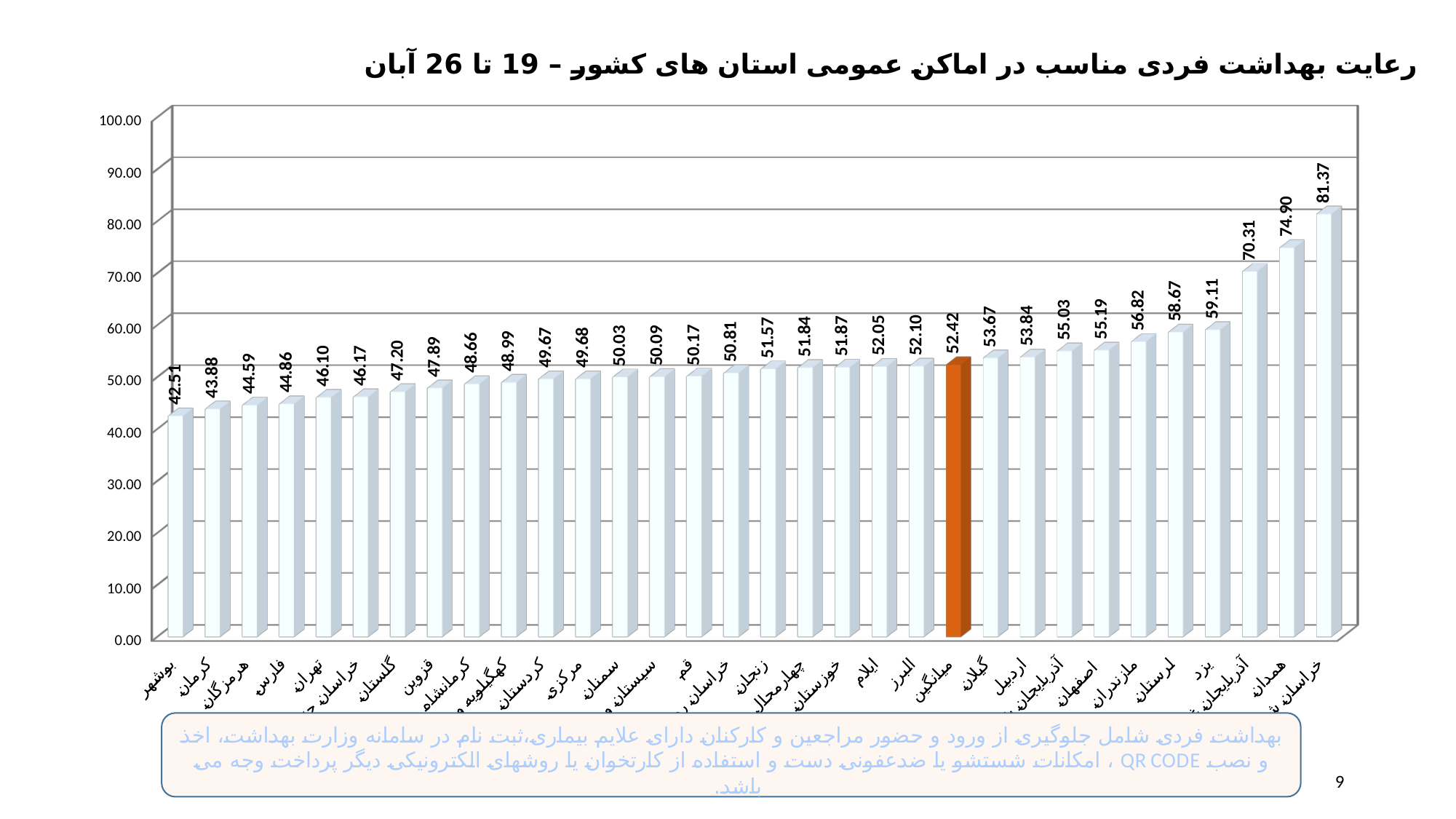
What is the value for اصفهان? 55.19 What is the value of the orange bar labelled میانگین? 52.42 What is the value for بوشهر? 42.51 Which category has the highest value? خراسان شمالی What is the value for همدان? 74.90 Which category has the lowest value? بوشهر Which is larger, the value for گیلان or the value for تهران? گیلان Do the values rise or fall from left to right along the x axis? rise How many bars are plotted in the chart? 32 What kind of chart is shown on the slide? bar chart Is the value for مازندران greater or less than 50.00? greater What is the difference between the values for یزد and لرستان? 0.44